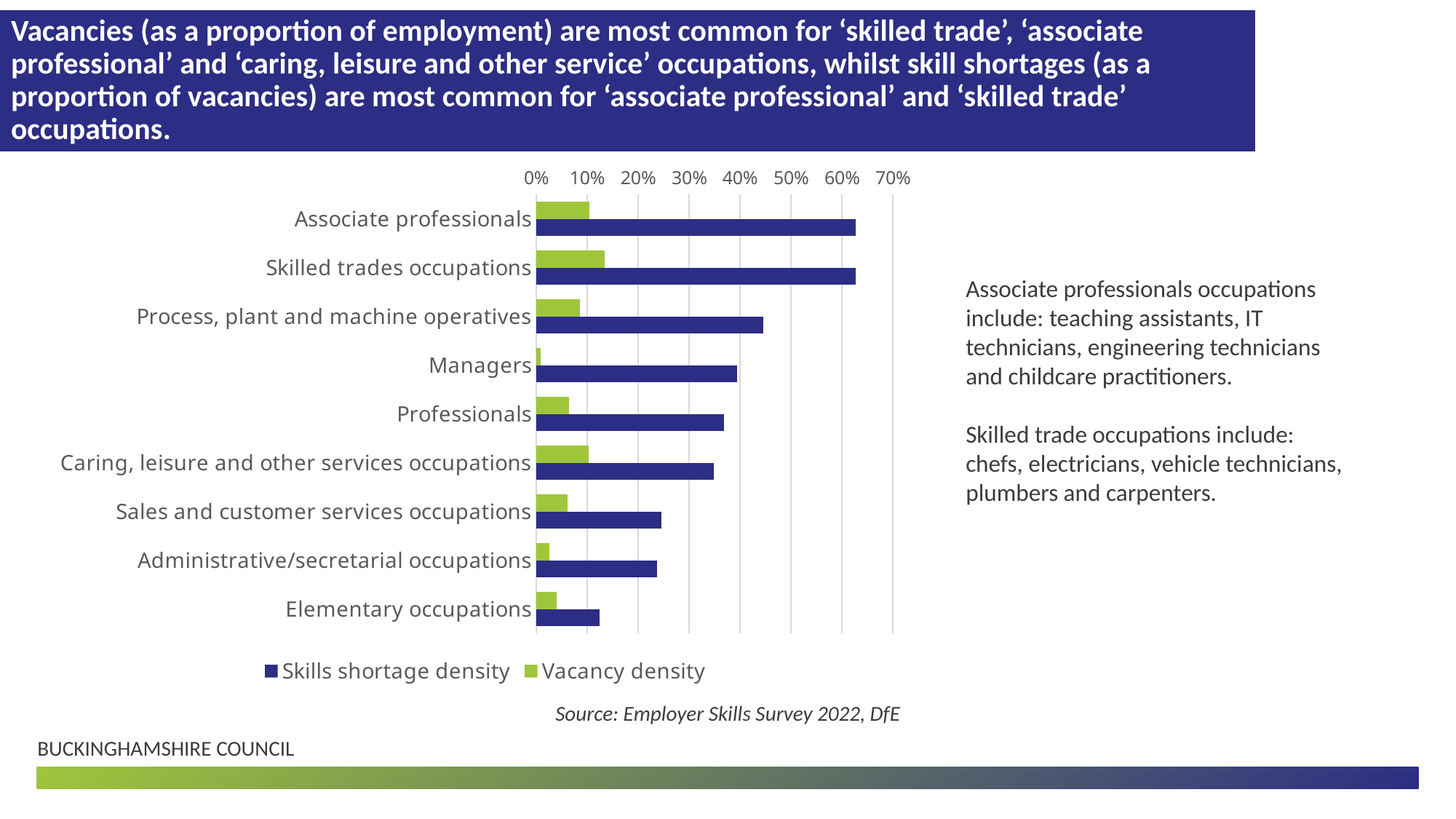
Is the skills shortage density for Process, plant and machine operatives greater or less than 40%? greater Is the skills shortage density for Elementary occupations greater or less than 20%? less Which occupation has the lowest skills shortage density? Elementary occupations Is the skills shortage density for Associate professionals greater or less than 60%? greater Which has the larger skills shortage density: Professionals or Sales and customer services occupations? Professionals Which has the larger vacancy density: Managers or Elementary occupations? Elementary occupations How many occupation categories are plotted in the chart? 9 Which occupation has the highest vacancy density? Skilled trades occupations How many series does the chart legend list? 2 What colour represents Vacancy density in the chart? Green What kind of chart is shown on the slide? Bar chart Which occupation has the lowest vacancy density? Managers